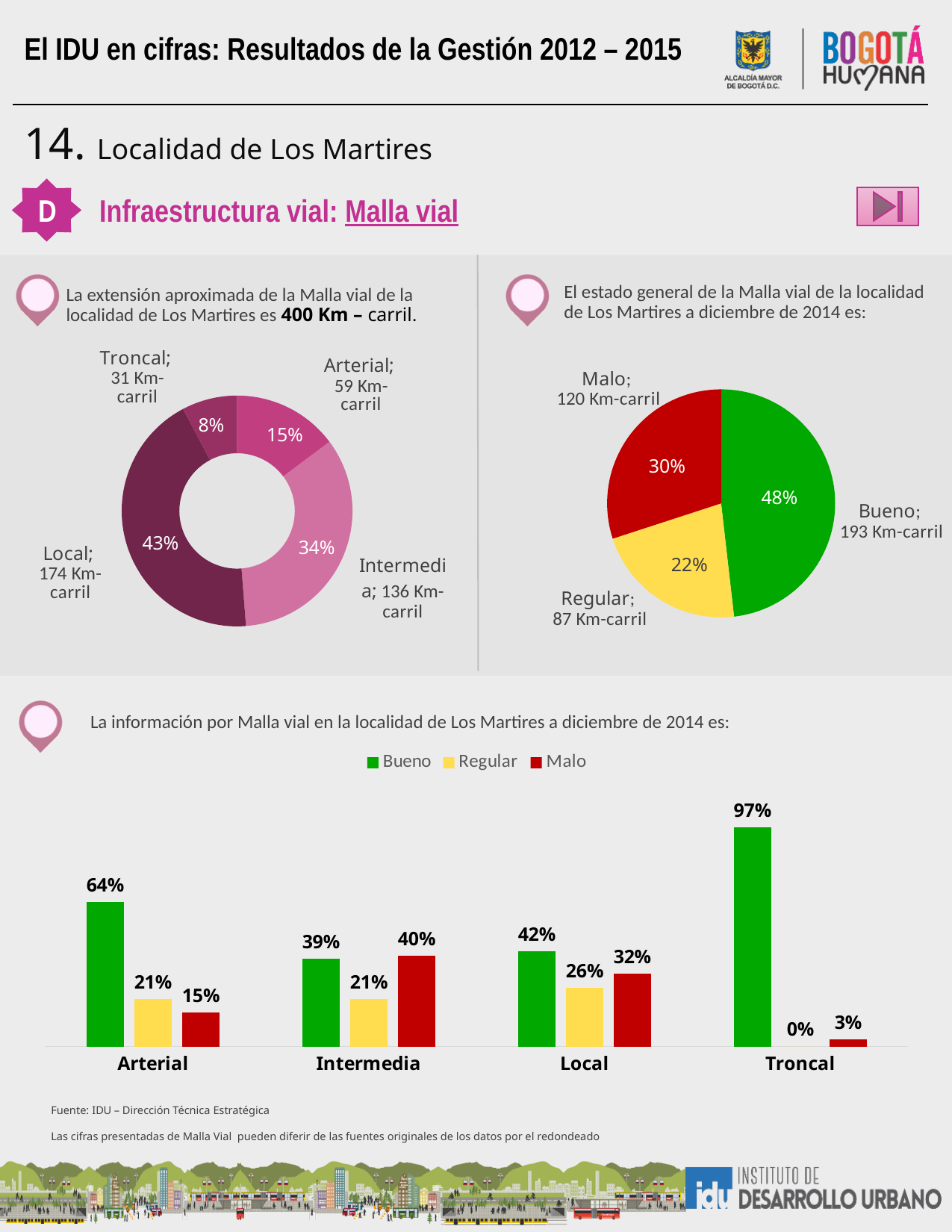
In the bottom bar chart, which is larger for Local: Regular or Malo? Malo In the left donut chart of road network extension, what percentage does Local represent? 43% In the right pie chart of road network state, what is the difference in Km-carril between Bueno and Regular? 106 Km-carril In the right pie chart of road network state, how many Km-carril are in Malo state? 120 Km-carril In the right pie chart of road network state, what percentage is Bueno? 48% In the left donut chart of road network extension, how many Km-carril does Arterial have? 59 Km-carril In the bottom bar chart, what is the Bueno value for Troncal? 97% In the bottom bar chart, what is the Malo value for Intermedia? 40% What type of chart is the bottom chart showing Bueno, Regular and Malo by road type? Bar chart In the bottom bar chart, how many series does the legend list? 3 In the right pie chart of road network state, which category has the largest share? Bueno In the left donut chart of road network extension, which category has the smallest share? Troncal